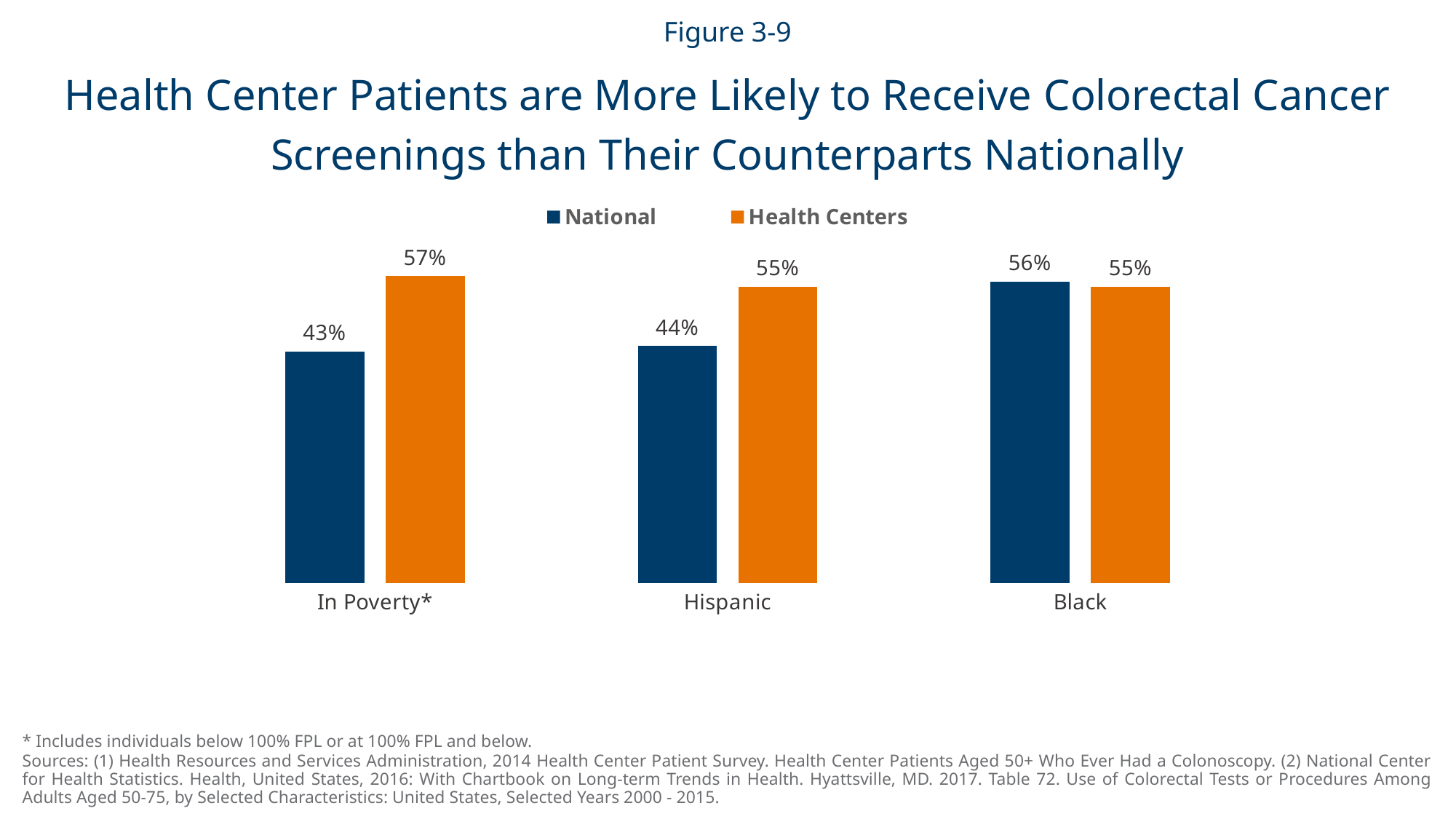
What kind of chart is shown on the slide? Bar chart What is the difference between the Health Centers and National values for Hispanic? 11% Which category has the lowest National value? In Poverty* What is the National value for In Poverty*? 43% What is the Health Centers value for In Poverty*? 57% What is the difference between the Health Centers and National values for In Poverty*? 14% What is the Health Centers value for Hispanic? 55% For Hispanic, which is larger: the National value or the Health Centers value? Health Centers What is the National value for Black? 56% How many categories are shown on the x axis? 3 Which category has the highest Health Centers value? In Poverty* How many series does the legend list? 2